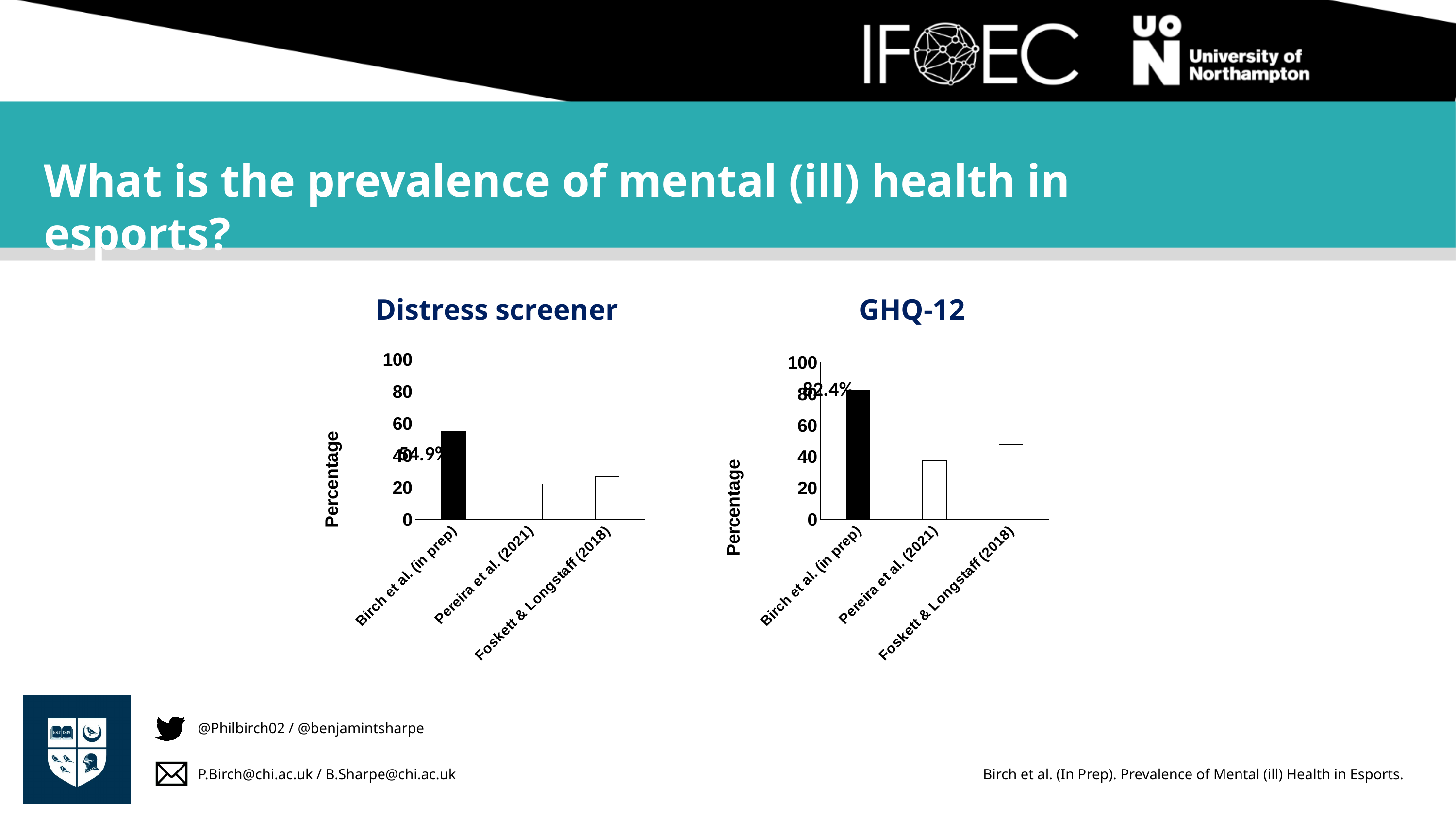
In the GHQ-12 chart, which is larger: the value for Foskett & Longstaff (2018) or the value for Pereira et al. (2021)? Foskett & Longstaff (2018) In the Distress screener chart, is the value for Pereira et al. (2021) greater or less than 40? less In the GHQ-12 chart, is the value for Pereira et al. (2021) greater or less than 20? greater In the Distress screener chart, which study has the lowest percentage? Pereira et al. (2021) In the GHQ-12 chart, is the value for Foskett & Longstaff (2018) greater or less than 40? greater In the GHQ-12 chart, which study has the lowest percentage? Pereira et al. (2021) In the GHQ-12 chart, what is the value for Birch et al. (in prep)? 82.4% What kind of chart is the GHQ-12 chart? Bar chart In the Distress screener chart, what is the value for Birch et al. (in prep)? 54.9% What is the y-axis label of the Distress screener chart? Percentage In the Distress screener chart, which study has the highest percentage? Birch et al. (in prep) How many studies are shown in the Distress screener chart? 3